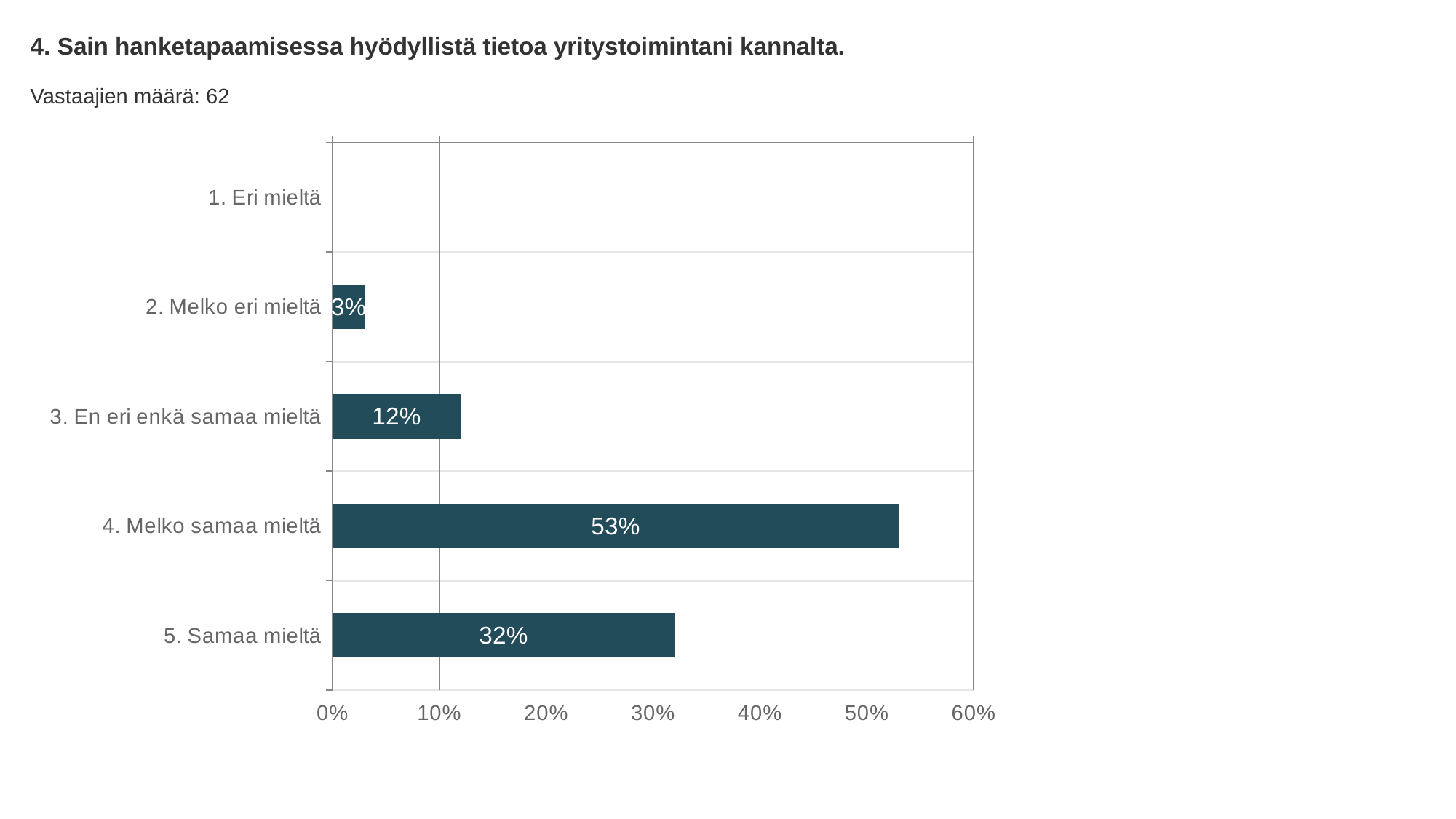
What percentage of respondents chose "2. Melko eri mieltä"? 3% What percentage of respondents chose "4. Melko samaa mieltä"? 53% How many respondents (Vastaajien määrä) are reported on the slide? 62 Is the value for "5. Samaa mieltä" greater or less than 40%? less Which category has the lowest percentage? 1. Eri mieltä How many categories are shown on the chart? 5 What percentage of respondents chose "5. Samaa mieltä"? 32% What percentage of respondents chose "3. En eri enkä samaa mieltä"? 12% Which category has the highest percentage? 4. Melko samaa mieltä What kind of chart is shown on the slide? bar chart Which is larger, the value for "3. En eri enkä samaa mieltä" or the value for "2. Melko eri mieltä"? 3. En eri enkä samaa mieltä What is the difference in percentage points between "4. Melko samaa mieltä" and "5. Samaa mieltä"? 21